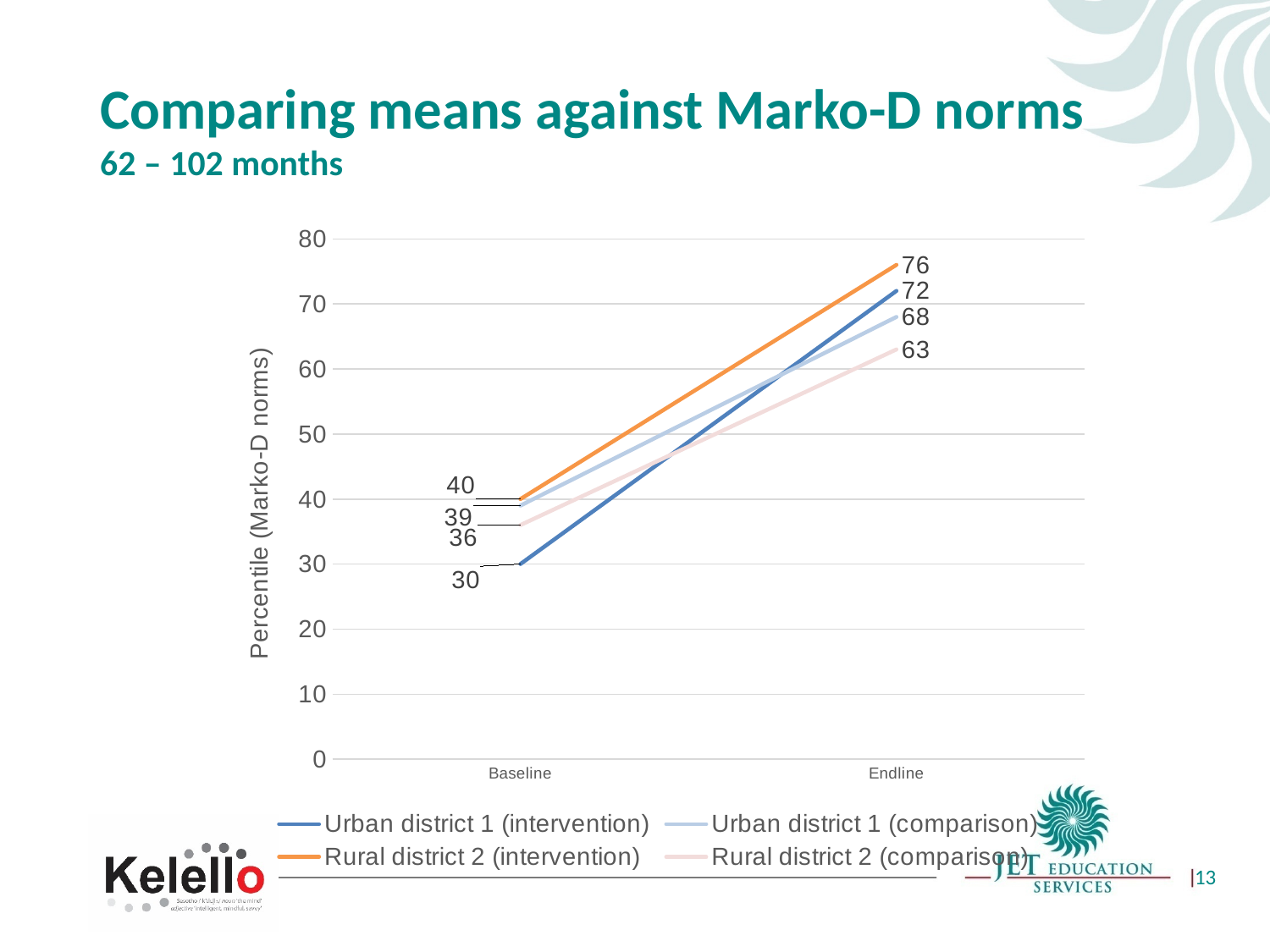
How many series does the legend list? 4 What is the Baseline value for Urban district 1 (intervention)? 30 What is the Baseline value for Urban district 1 (comparison)? 39 What is the Endline value for Rural district 2 (intervention)? 76 Which series has the lowest value at Baseline? Urban district 1 (intervention) At Endline, which is larger: Urban district 1 (comparison) or Rural district 2 (comparison)? Urban district 1 (comparison) Which series has the highest value at Endline? Rural district 2 (intervention) What is the Endline value for Rural district 2 (comparison)? 63 What is the label of the vertical axis? Percentile (Marko-D norms) By how much did Urban district 1 (intervention) increase from Baseline to Endline? 42 What kind of chart is shown on the slide? Line chart Do the values for Rural district 2 (comparison) rise or fall from Baseline to Endline? Rise